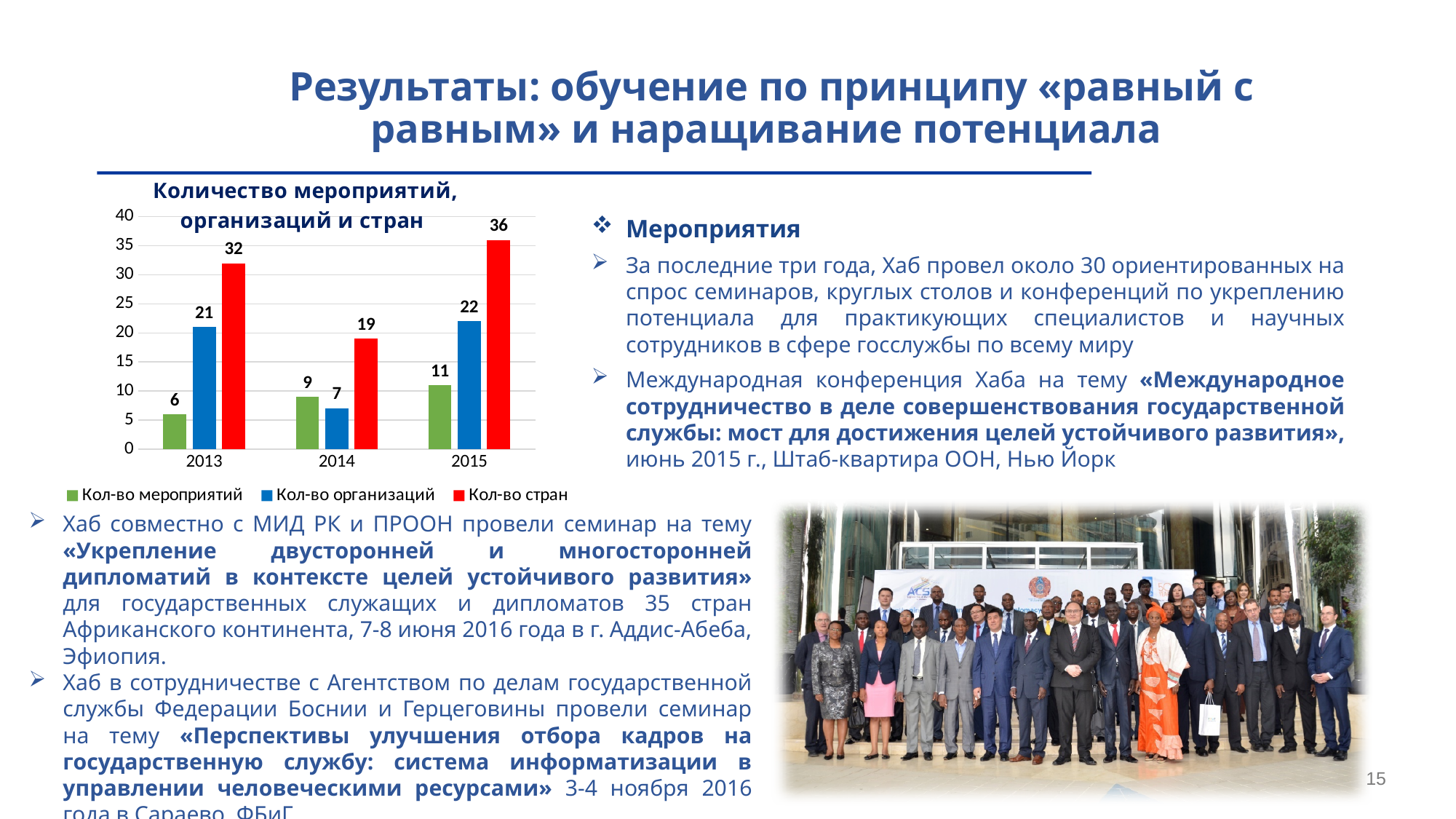
What is the value of 'Кол-во мероприятий' for 2014? 9 What kind of chart is shown on the slide? Bar chart Which is larger: 'Кол-во организаций' in 2014 or 'Кол-во мероприятий' in 2014? Кол-во мероприятий What is the value of 'Кол-во стран' for 2015? 36 How many years are shown on the x axis of the chart? 3 Which year has the highest value for 'Кол-во стран'? 2015 How many series does the chart legend list? 3 Does 'Кол-во мероприятий' rise or fall from 2013 to 2015? Rise What colour represents 'Кол-во стран' in the chart? Red What is the value of 'Кол-во организаций' for 2013? 21 What is the difference between 'Кол-во стран' in 2015 and in 2014? 17 Which year has the lowest value for 'Кол-во мероприятий'? 2013